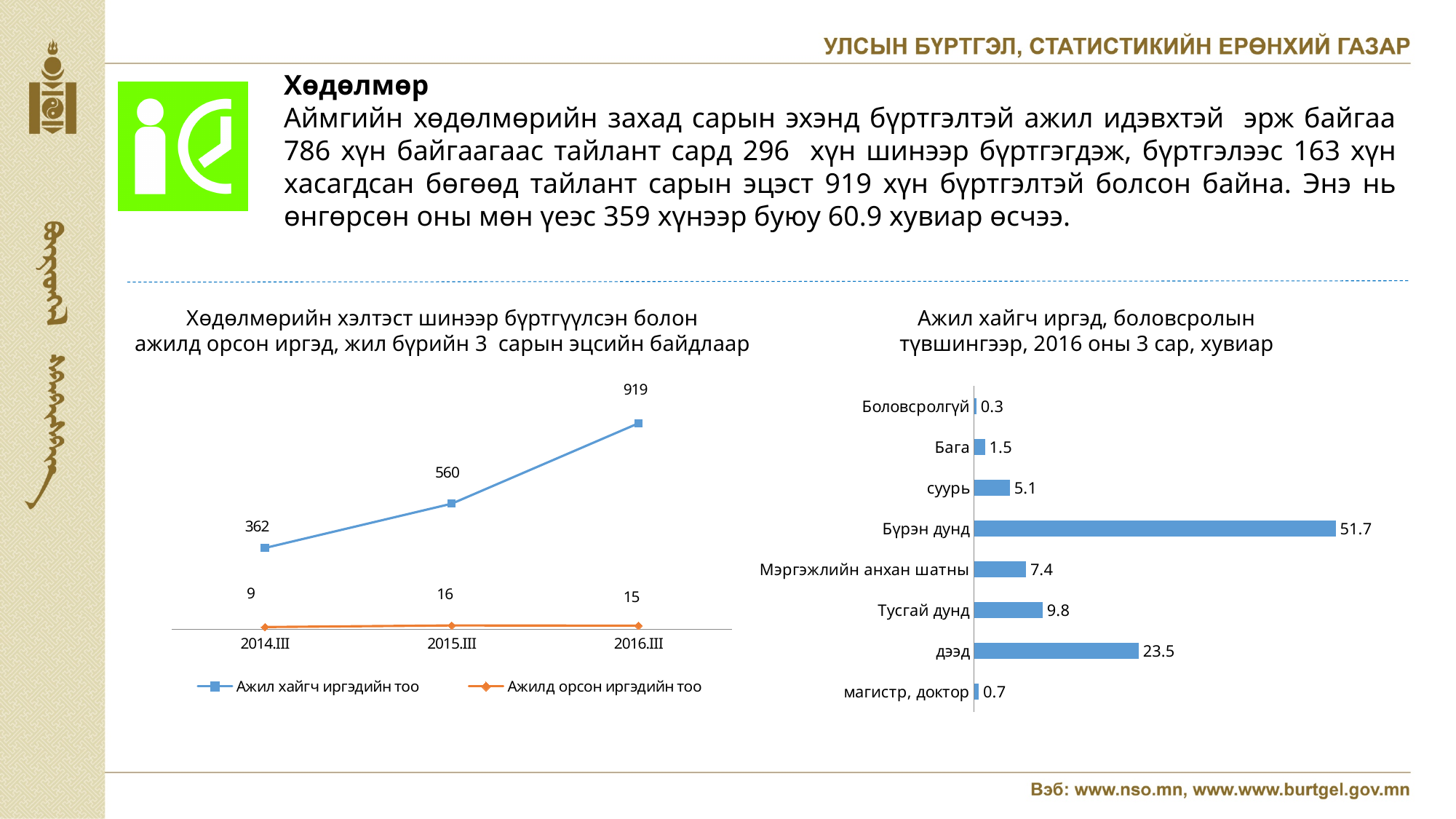
In the right chart, what is the value for Бүрэн дунд? 51.7 What kind of chart is the left chart? line chart How many series does the legend of the left chart list? 2 In the left chart, does Ажил хайгч иргэдийн тоо rise or fall from 2014.III to 2016.III? rise In the right chart, which category has the highest value? Бүрэн дунд In the left chart, what is the value of Ажилд орсон иргэдийн тоо for 2015.III? 16 In the right chart, which category has the lowest value? Боловсролгүй How many categories are shown in the right chart? 8 In the left chart, what is the value of Ажил хайгч иргэдийн тоо for 2016.III? 919 In the right chart, which is larger, дээд or Тусгай дунд? дээд In the left chart, what is the difference between Ажил хайгч иргэдийн тоо in 2016.III and 2014.III? 557 What kind of chart is the right chart? bar chart